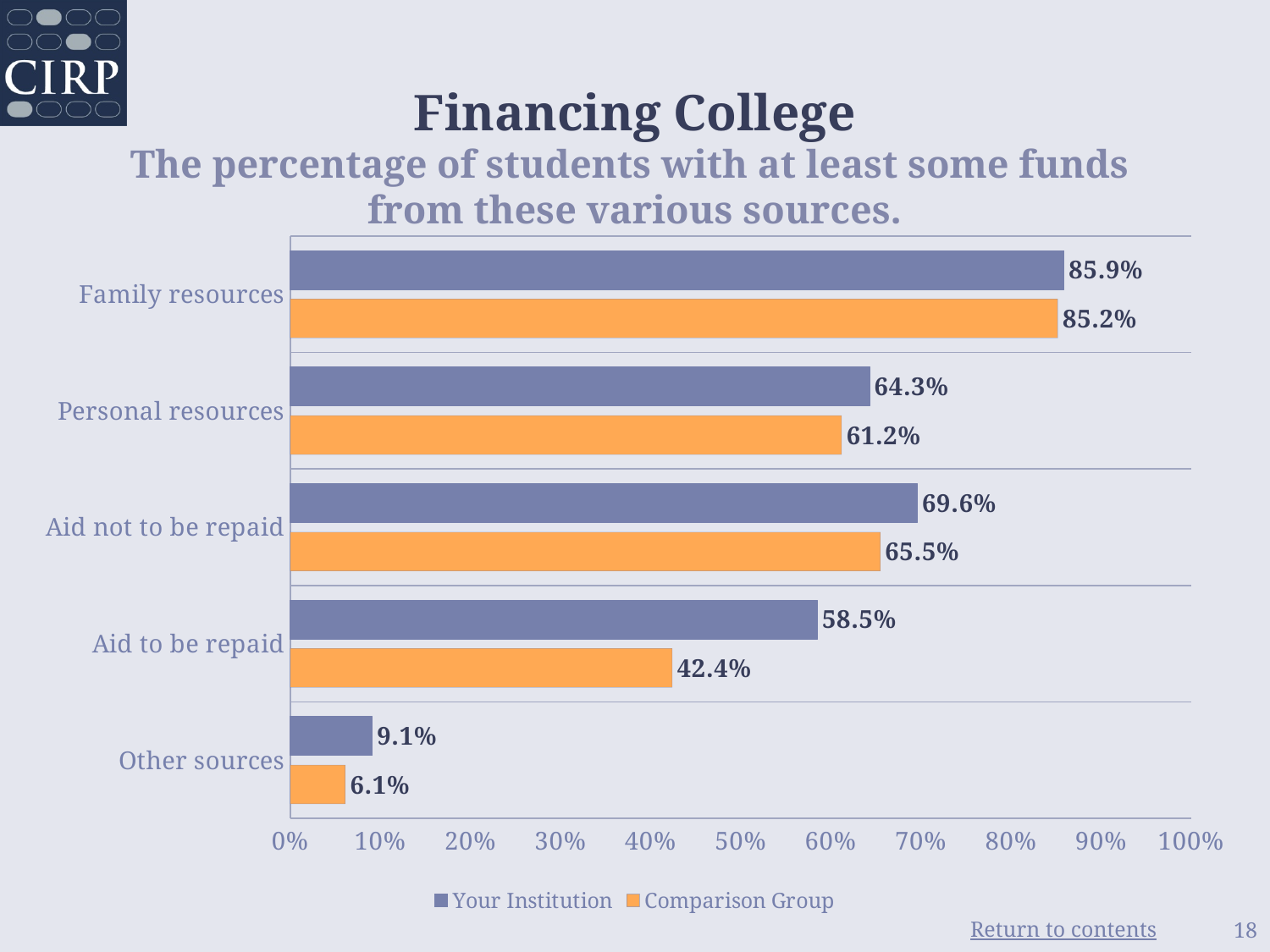
What is the value for Aid to be repaid for the Comparison Group? 42.4% What is the difference between Your Institution and the Comparison Group for Aid to be repaid? 16.1% Which category has the lowest value for Your Institution? Other sources What colour represents the Comparison Group in the chart? Orange How many series does the legend list? 2 What kind of chart is shown on the slide? Bar chart What is the value for Other sources for Your Institution? 9.1% Which is larger for Personal resources: Your Institution or the Comparison Group? Your Institution How many categories are shown on the chart? 5 Which category has the highest value for the Comparison Group? Family resources What is the difference between Your Institution and the Comparison Group for Aid not to be repaid? 4.1% What is the value for Family resources for Your Institution? 85.9%